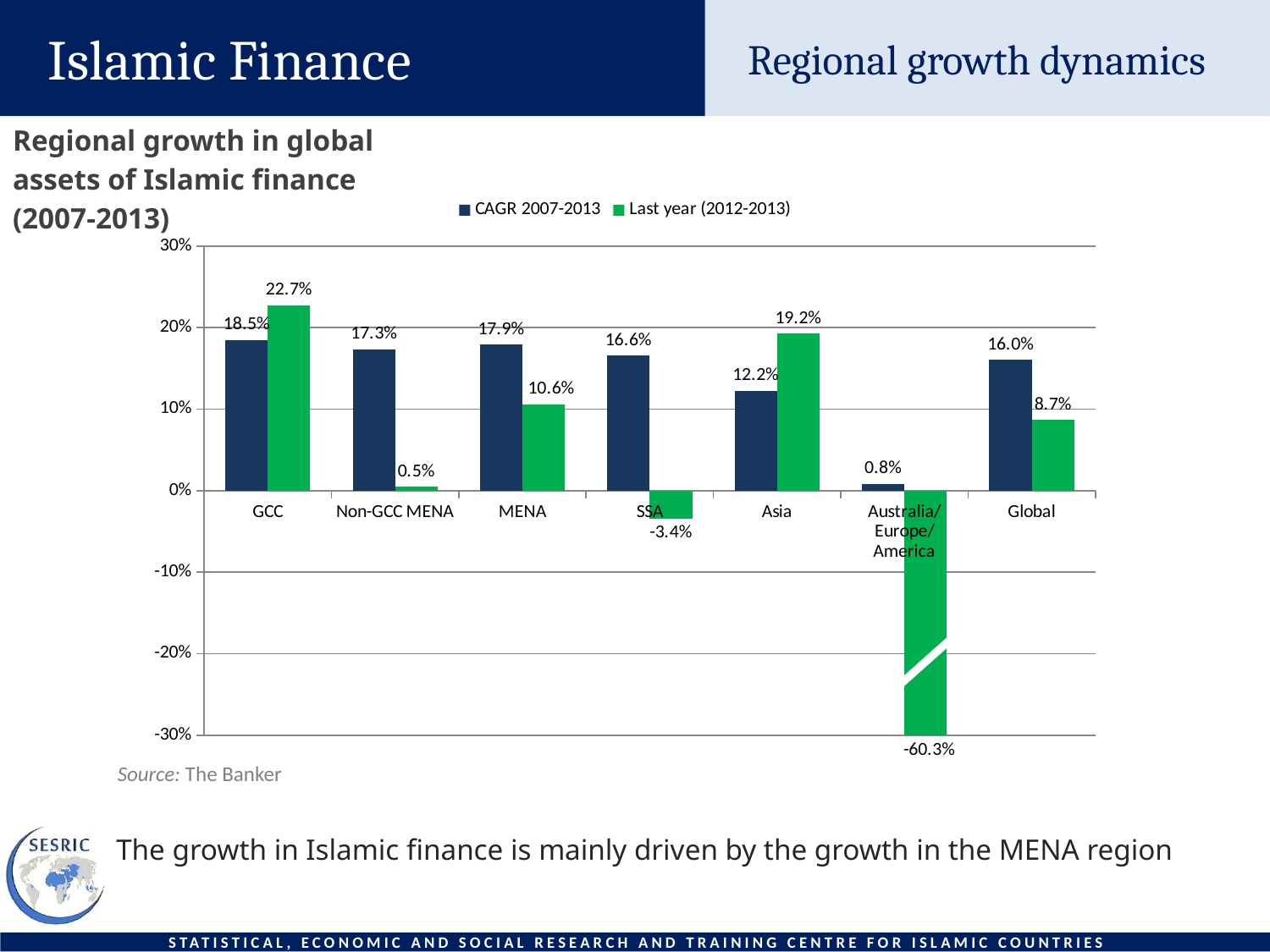
What is the difference between the CAGR 2007-2013 and Last year (2012-2013) values for MENA? 7.3% What is the source cited below the chart? The Banker What is the CAGR 2007-2013 value for GCC? 18.5% Which region has the highest Last year (2012-2013) value? GCC What is the Last year (2012-2013) value for Asia? 19.2% How many series does the legend list? 2 What is the Last year (2012-2013) value for Australia/Europe/America? -60.3% Which region has the lowest CAGR 2007-2013 value? Australia/Europe/America What is the CAGR 2007-2013 value for Global? 16.0% Which is larger for SSA: the CAGR 2007-2013 value or the Last year (2012-2013) value? CAGR 2007-2013 What kind of chart is shown on the slide? Bar chart How many regions are shown on the x axis of the chart? 7